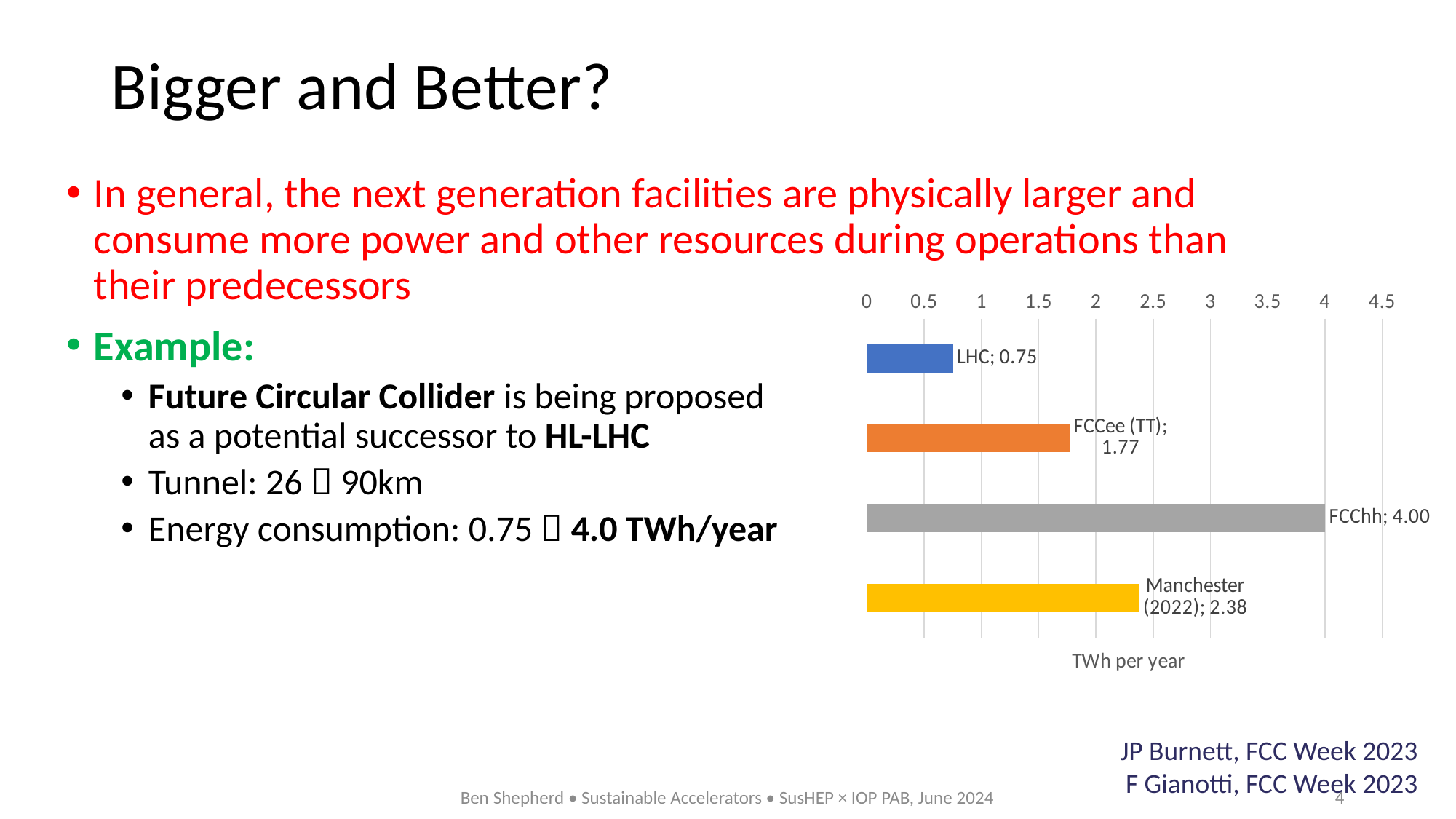
What is the value for Manchester (2022) in the bar chart? 2.38 What is the value for LHC in the bar chart? 0.75 What is the value for FCChh in the bar chart? 4.00 What is the value for FCCee (TT) in the bar chart? 1.77 Which category has the highest value in the bar chart? FCChh How many bars are shown in the chart? 4 What is the difference between the values for Manchester (2022) and FCCee (TT)? 0.61 Which category has the lowest value in the bar chart? LHC What is the axis label shown below the chart? TWh per year What kind of chart is shown on the slide? Bar chart What is the difference between the values for FCChh and LHC? 3.25 Which is larger, the value for Manchester (2022) or the value for FCCee (TT)? Manchester (2022)